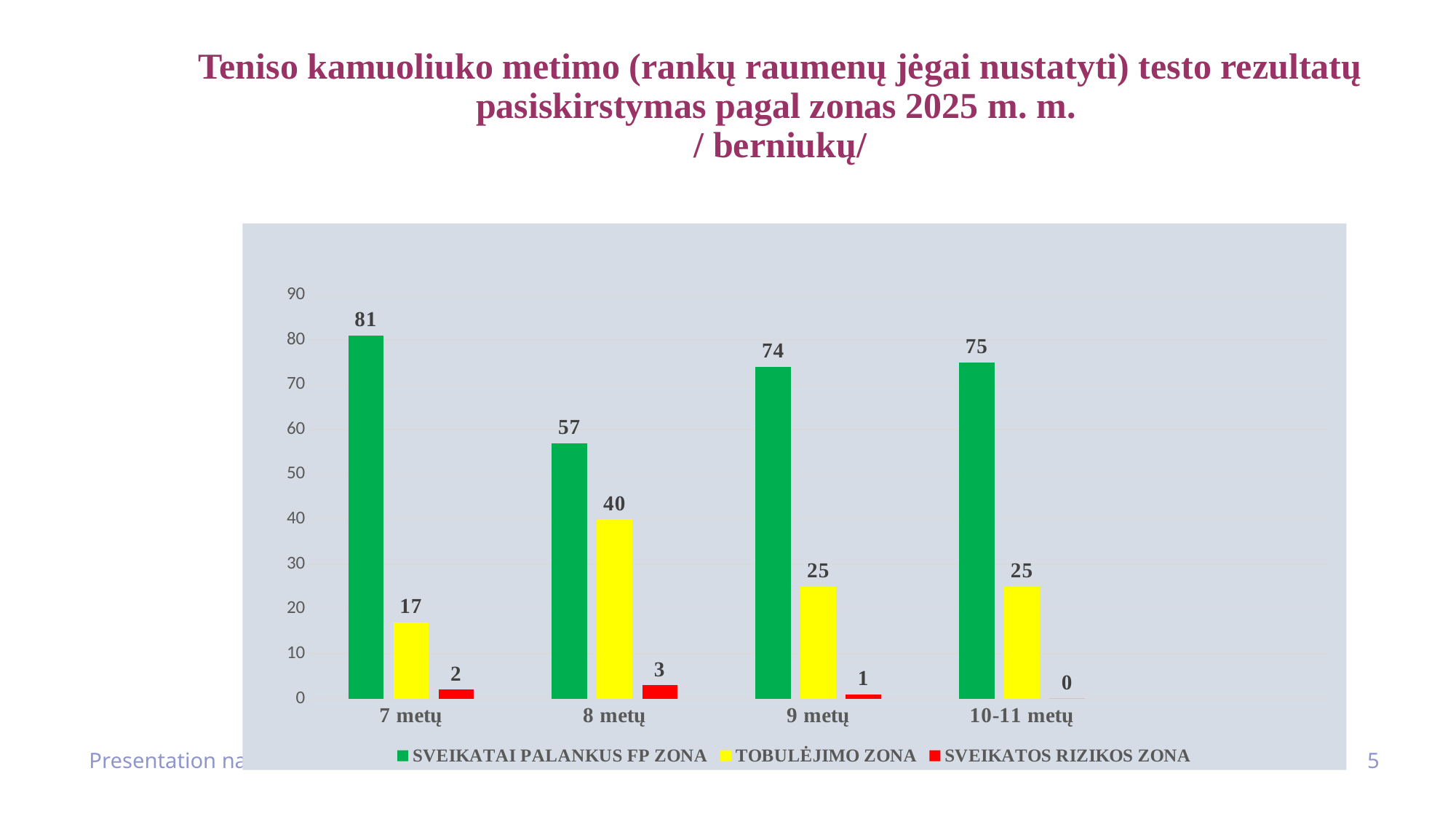
What is the value for SVEIKATAI PALANKUS FP ZONA for 7 metų? 81 How many series does the legend list? 3 What kind of chart is shown on the slide? bar chart Which age group has the lowest value for SVEIKATAI PALANKUS FP ZONA? 8 metų Which colour represents SVEIKATOS RIZIKOS ZONA in the chart? red Which age group has the highest value for SVEIKATAI PALANKUS FP ZONA? 7 metų How many age groups are shown on the x axis? 4 What is the value for TOBULĖJIMO ZONA for 8 metų? 40 What is the difference between the SVEIKATAI PALANKUS FP ZONA values for 7 metų and 8 metų? 24 What is the value for SVEIKATOS RIZIKOS ZONA for 10-11 metų? 0 Is the SVEIKATAI PALANKUS FP ZONA value for 9 metų greater or less than 70? greater Which is larger: the TOBULĖJIMO ZONA value for 8 metų or for 9 metų? 8 metų